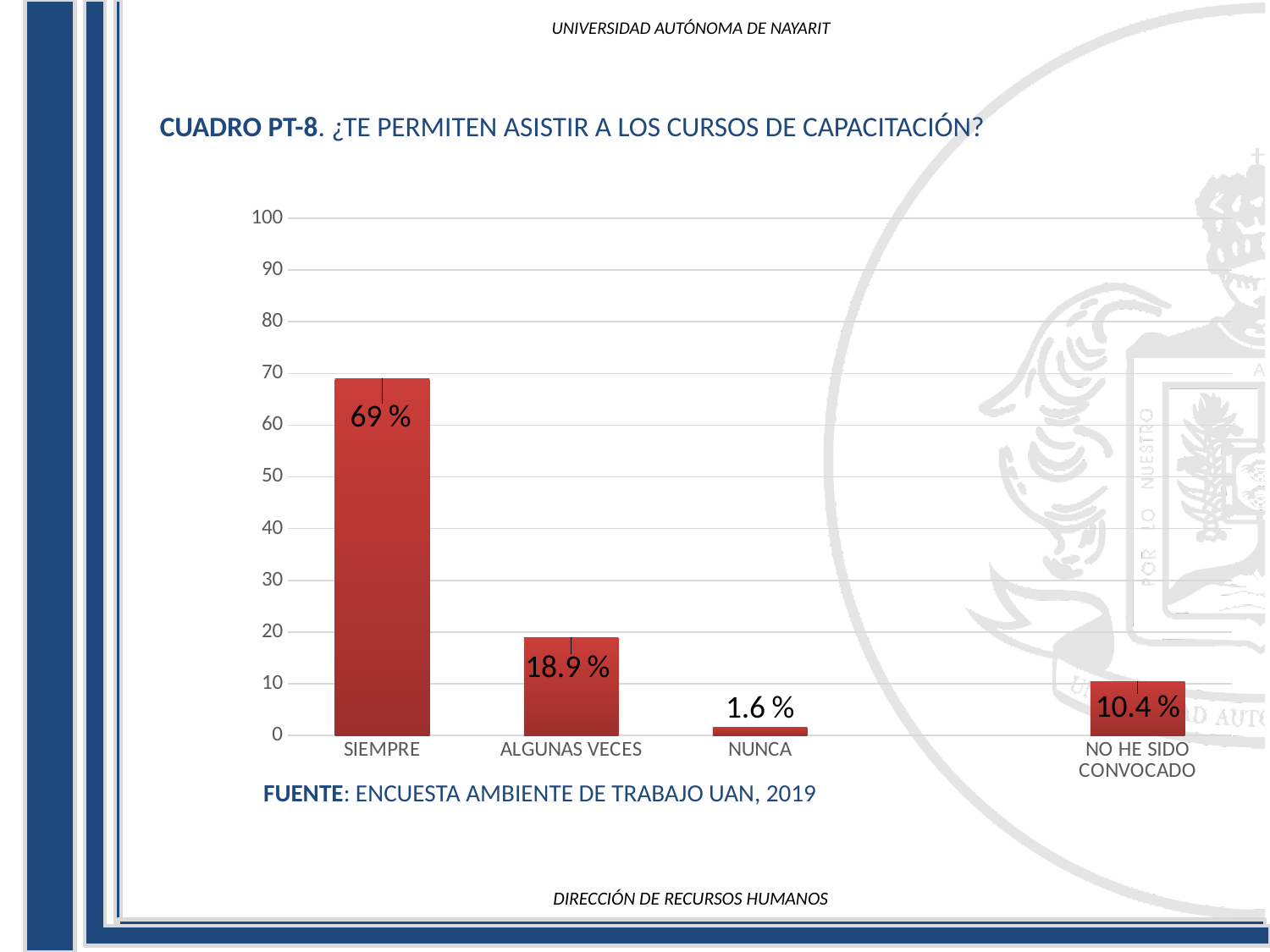
Which category has the lowest value? NUNCA Which is larger, the value for ALGUNAS VECES or the value for NO HE SIDO CONVOCADO? ALGUNAS VECES What is the value for NUNCA? 1.6 % What is the difference between the values for SIEMPRE and ALGUNAS VECES? 50.1 % Is the value for SIEMPRE greater or less than 60? greater What kind of chart is shown on the slide? bar chart Which category has the highest value? SIEMPRE What is the value for NO HE SIDO CONVOCADO? 10.4 % How many categories are shown on the x axis? 4 What is the value for SIEMPRE? 69 % What is the source cited below the chart? ENCUESTA AMBIENTE DE TRABAJO UAN, 2019 What is the value for ALGUNAS VECES? 18.9 %